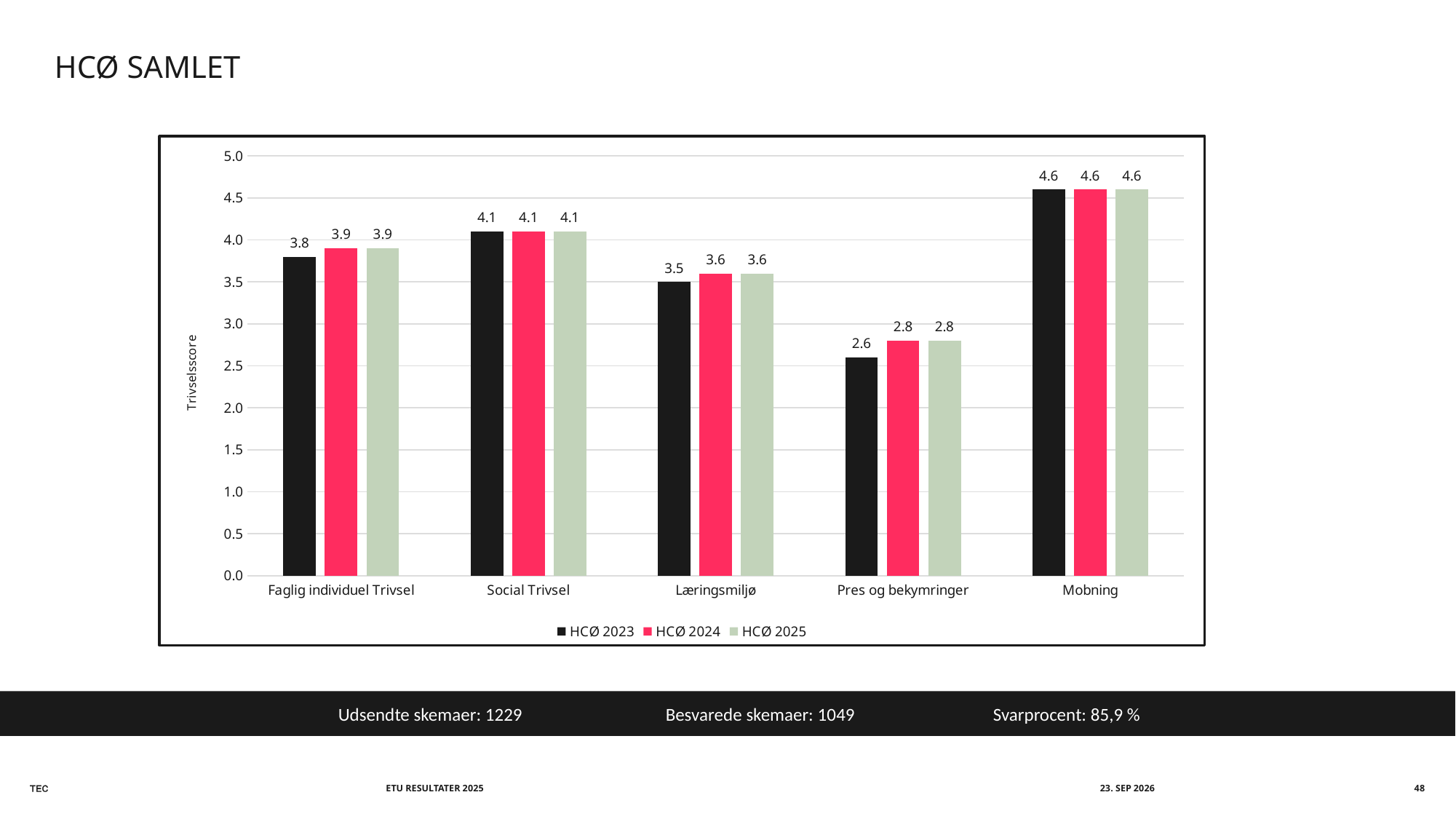
Which category has the lowest value for HCØ 2023? Pres og bekymringer What is the value for HCØ 2024 in the Læringsmiljø category? 3.6 What is the value for HCØ 2023 in the Faglig individuel Trivsel category? 3.8 What is the label of the y axis? Trivselsscore What is the value for HCØ 2025 in the Pres og bekymringer category? 2.8 Which category has the highest value for HCØ 2025? Mobning How many categories are shown on the x axis? 5 What kind of chart is shown on the slide? Bar chart Is the value for HCØ 2023 in the Mobning category greater or less than 4.0? greater What is the difference between the HCØ 2024 and HCØ 2023 values in the Pres og bekymringer category? 0.2 How many series does the legend list? 3 Which is larger in the Læringsmiljø category: the HCØ 2023 value or the HCØ 2025 value? HCØ 2025